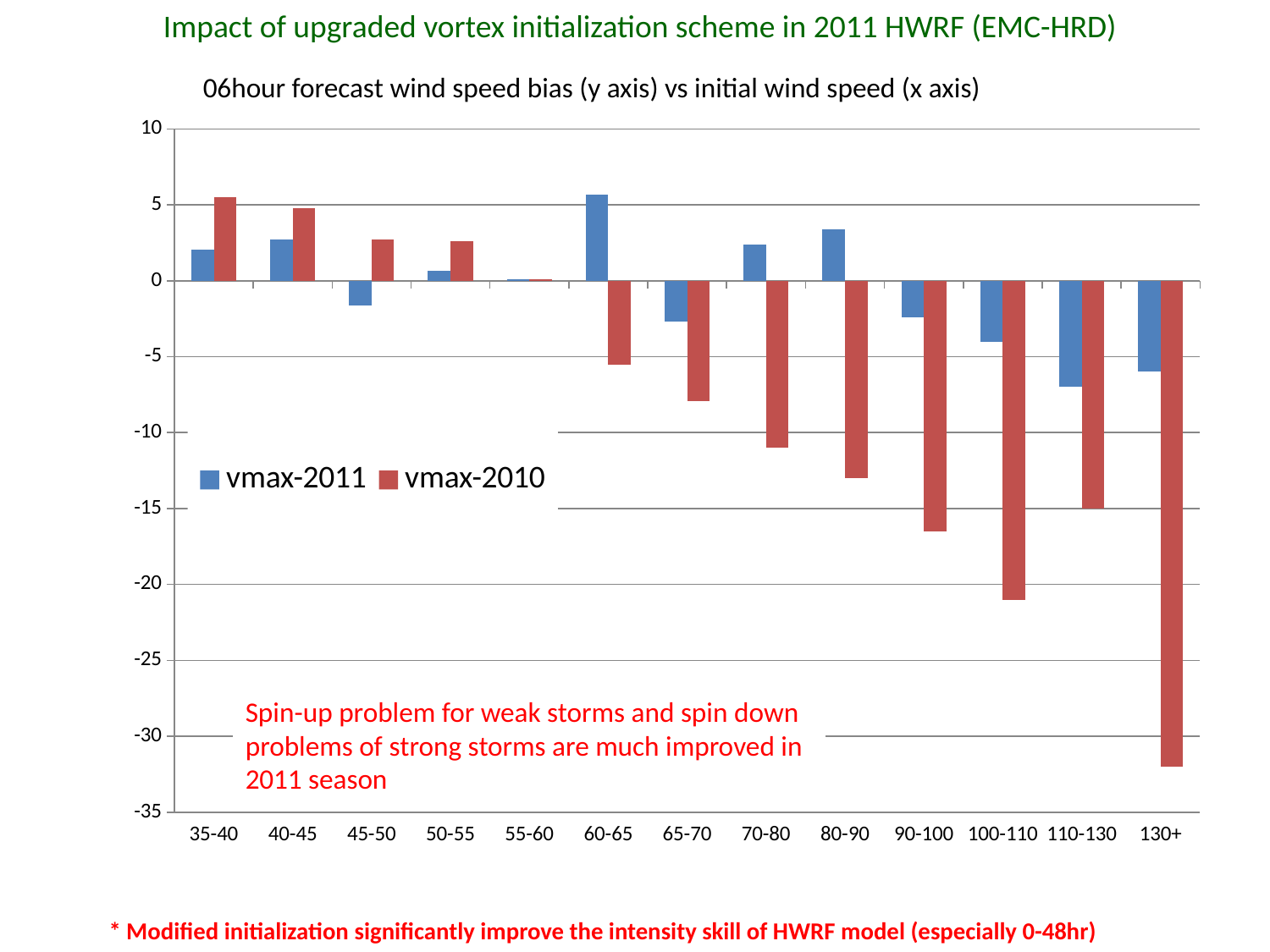
For the 130+ category, which series has the larger value, vmax-2011 or vmax-2010? vmax-2011 For the 35-40 category, which series has the larger value, vmax-2011 or vmax-2010? vmax-2010 Which colour represents the vmax-2010 series? red Is the vmax-2010 value for 130+ greater or less than -30? less Which category has the lowest value for vmax-2010? 130+ How many series does the legend list? 2 Which category has the highest value for vmax-2010? 35-40 How many initial wind speed categories are shown on the x axis? 13 Is the vmax-2011 value for 60-65 greater or less than 5? greater What kind of chart is shown on the slide? bar chart Which category has the highest value for vmax-2011? 60-65 Is the vmax-2010 value for 100-110 greater or less than -20? less